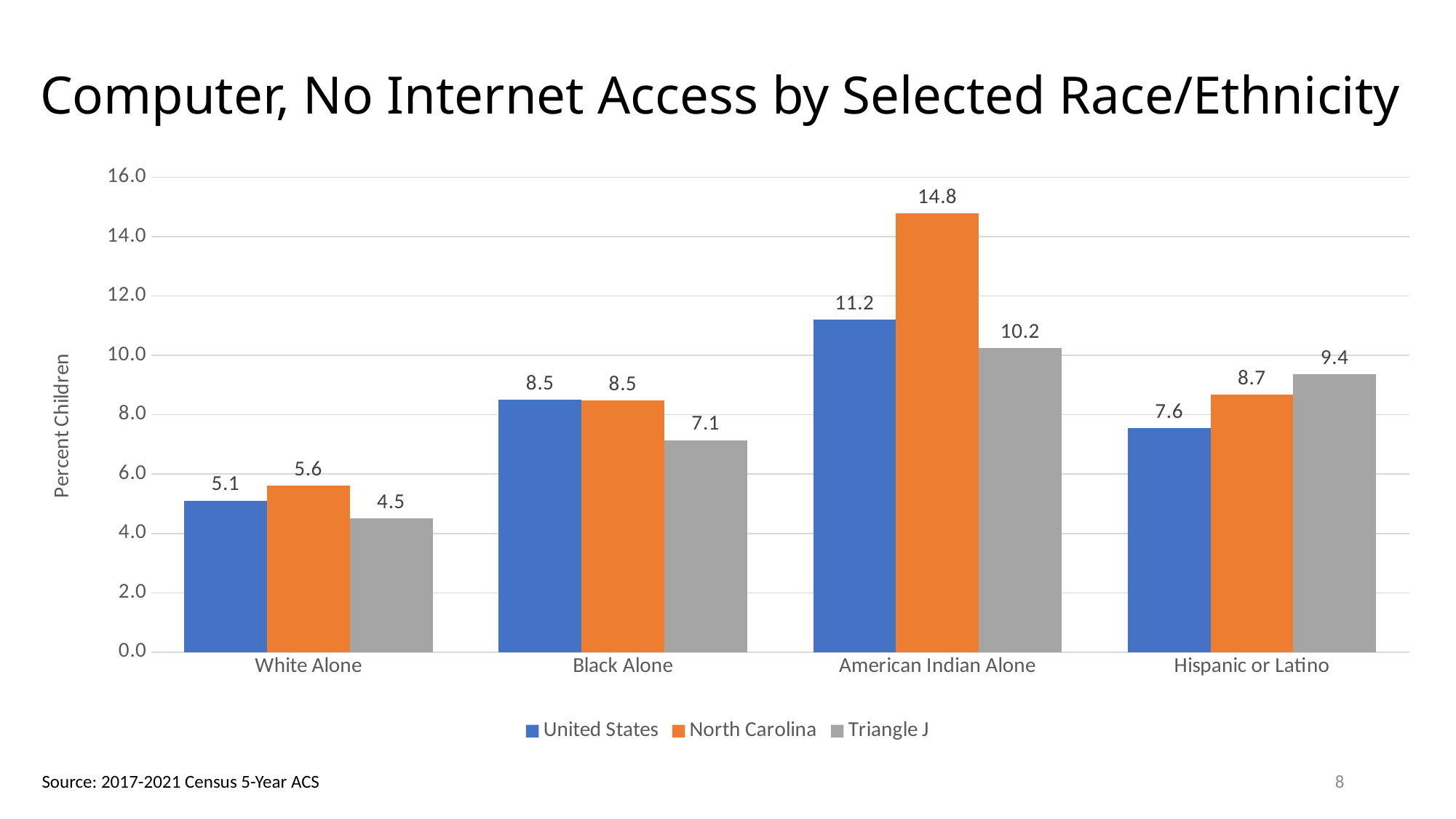
What is the North Carolina value for American Indian Alone? 14.8 What is the difference between the North Carolina and Triangle J values for American Indian Alone? 4.6 What kind of chart is shown on the slide? Bar chart How many race/ethnicity categories are shown on the x axis? 4 What is the label on the vertical axis? Percent Children For Hispanic or Latino, which is larger: the North Carolina value or the Triangle J value? Triangle J How many series does the legend list? 3 What is the United States value for Hispanic or Latino? 7.6 What is the Triangle J value for White Alone? 4.5 Which race/ethnicity category has the lowest United States value? White Alone Which race/ethnicity category has the highest Triangle J value? American Indian Alone Is the United States value for American Indian Alone greater or less than 10.0? greater